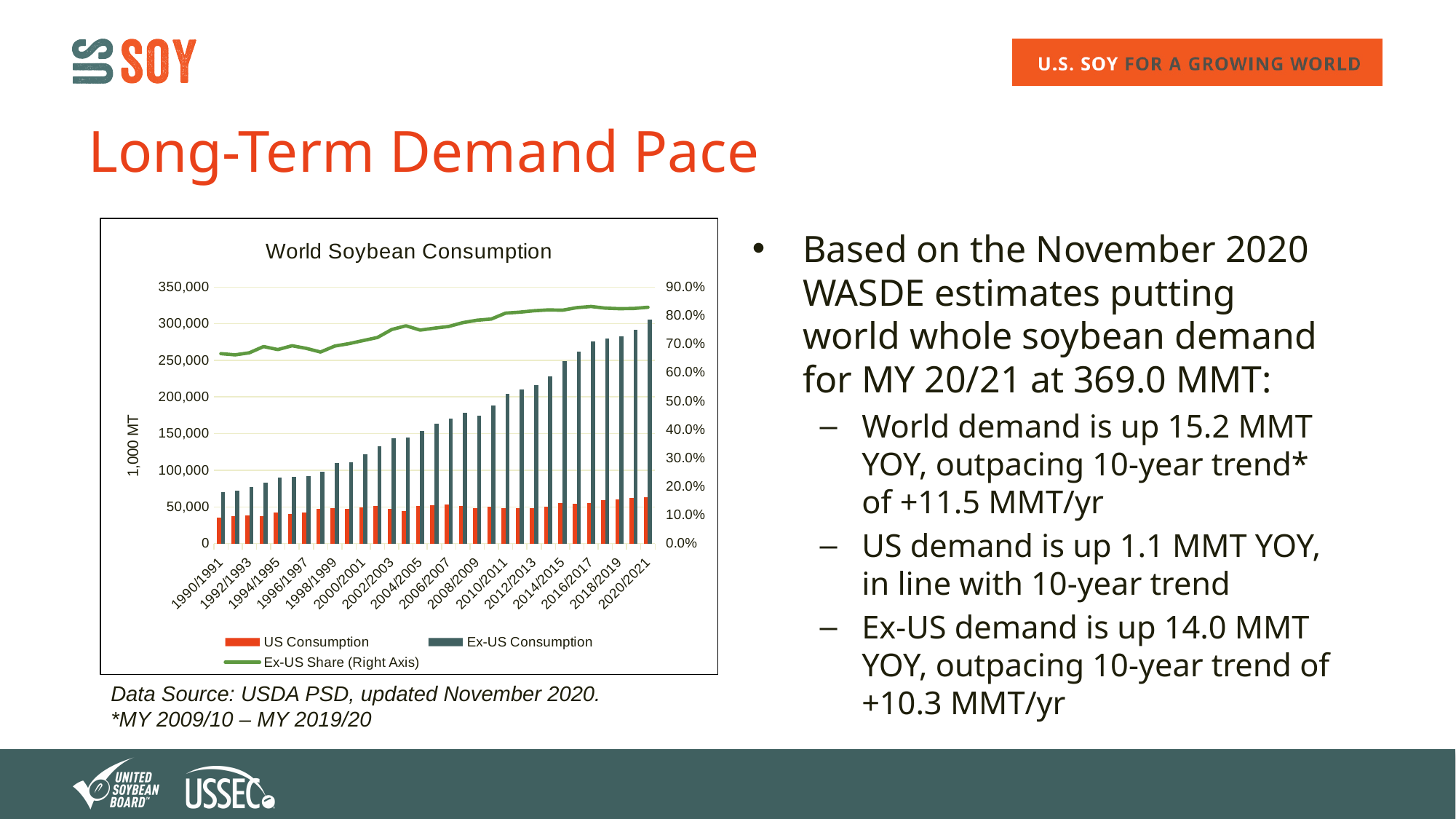
In 2020/2021, which is larger: US Consumption or Ex-US Consumption? Ex-US Consumption Is the Ex-US Consumption value for 2020/2021 greater or less than 250,000? greater In which year is Ex-US Consumption highest? 2020/2021 Does Ex-US Consumption generally rise or fall from 1990/1991 to 2020/2021? Rise Is the Ex-US Consumption value for 1990/1991 greater or less than 100,000? less What is the title of the chart on the slide? World Soybean Consumption Is the Ex-US Share value for 2020/2021 greater or less than 70.0%? greater What kind of chart is used for the US Consumption and Ex-US Consumption series? Bar chart In which year is Ex-US Consumption lowest? 1990/1991 Which series is plotted on the right axis according to the legend? Ex-US Share (Right Axis) How many series does the chart's legend list? 3